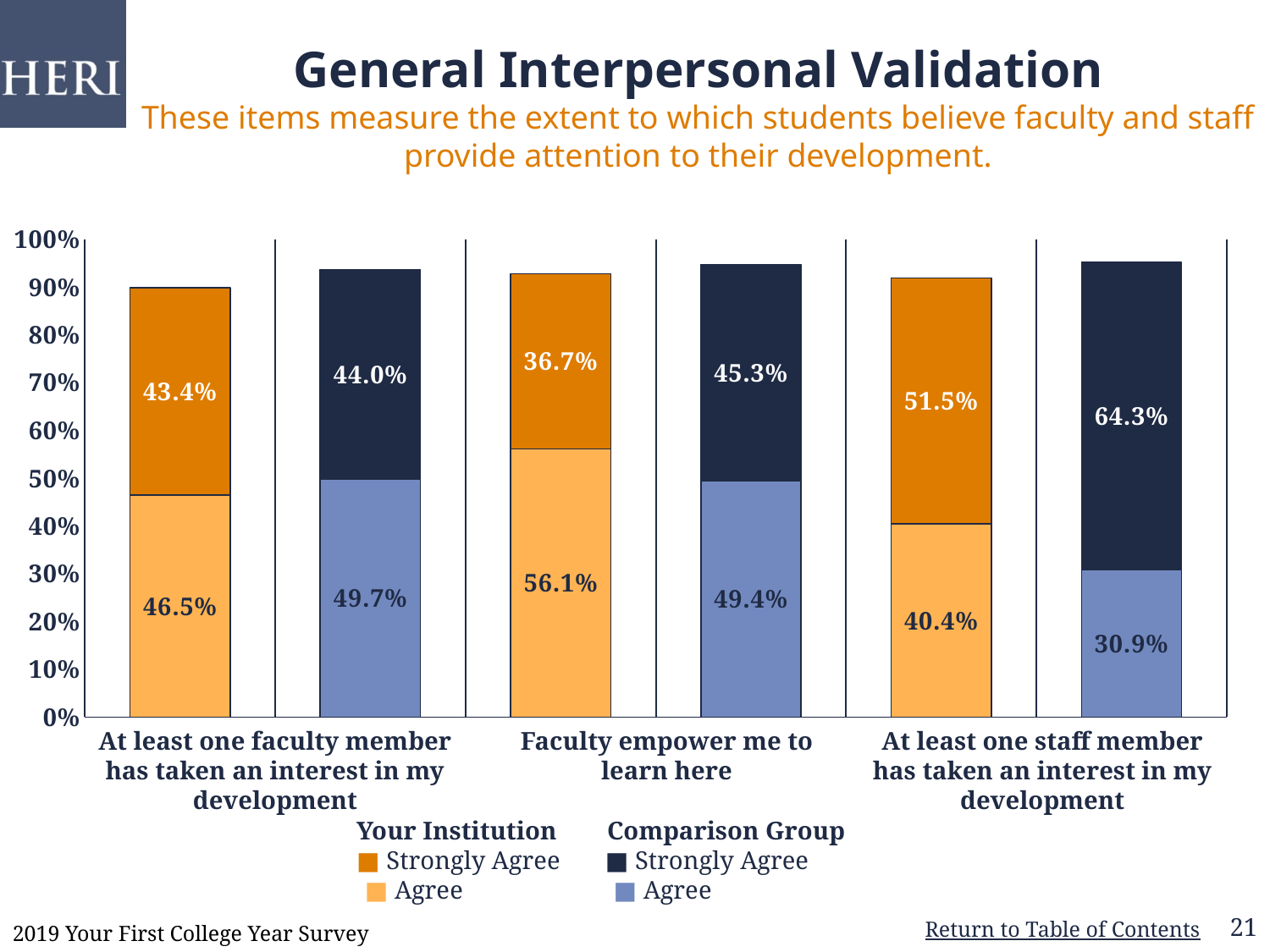
What is the difference between the Comparison Group and Your Institution Strongly Agree percentages for 'At least one staff member has taken an interest in my development'? 12.8% Which item has the lowest Agree percentage for the Comparison Group? At least one staff member has taken an interest in my development Which item has the highest Strongly Agree percentage for Your Institution? At least one staff member has taken an interest in my development For 'Faculty empower me to learn here', which group has the larger Strongly Agree percentage, Your Institution or the Comparison Group? Comparison Group How many entries does the chart legend list? 4 What percentage of Comparison Group students Agree that faculty empower them to learn here? 49.4% What is the total percentage (Agree plus Strongly Agree) for the Comparison Group on 'At least one staff member has taken an interest in my development'? 95.2% What percentage of Comparison Group students Strongly Agree that at least one staff member has taken an interest in their development? 64.3% What type of chart is shown on the slide? Stacked bar chart What percentage of Your Institution students Strongly Agree that at least one faculty member has taken an interest in their development? 43.4% What is the total percentage (Agree plus Strongly Agree) for Your Institution on 'Faculty empower me to learn here'? 92.8% How many survey items are shown on the x axis of the chart? 3